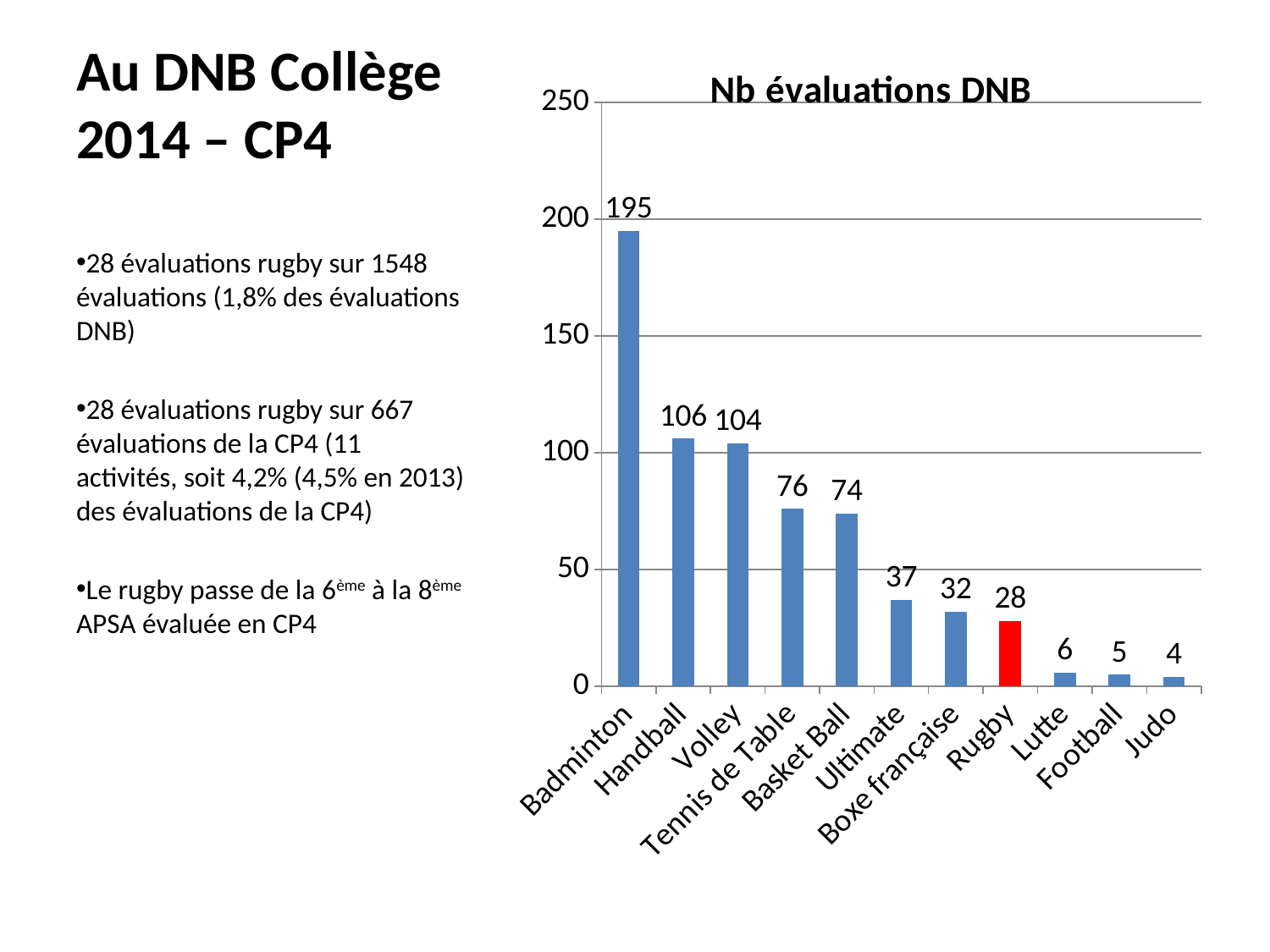
What is the title of the chart? Nb évaluations DNB What is the value for Rugby? 28 What is the value for Tennis de Table? 76 Which category has the lowest value? Judo Which category has the highest value? Badminton What is the difference between the values for Handball and Volley? 2 What is the difference between the values for Badminton and Rugby? 167 What is the value for Badminton? 195 Do the values rise or fall from left to right along the x axis? Fall Which is larger, the value for Ultimate or the value for Boxe française? Ultimate What kind of chart is this? Bar chart How many categories are shown on the x axis? 11